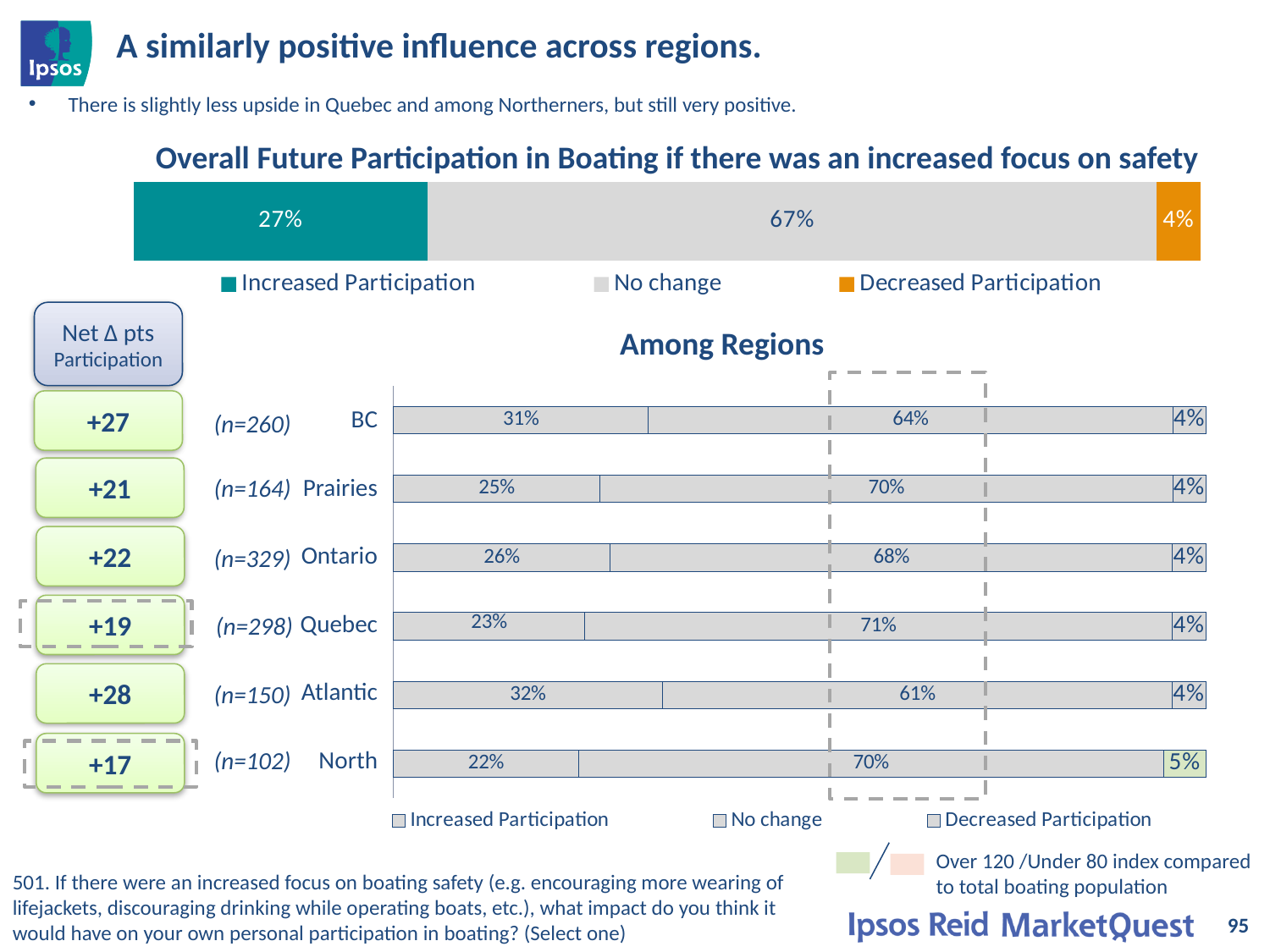
In the top 'Overall Future Participation in Boating if there was an increased focus on safety' chart, what is the No change value? 67% In the 'Among Regions' chart, what is the difference between the Increased Participation values for Atlantic and Quebec? 9 percentage points How many series does the legend of the 'Among Regions' chart list? 3 What type of chart is the 'Among Regions' chart? Stacked bar chart In the 'Among Regions' chart, which region has the lowest Increased Participation value? North In the 'Among Regions' chart, what percentage of BC respondents indicated Increased Participation? 31% In the top overall chart, what is the difference between the Increased Participation and Decreased Participation values? 23 percentage points How many regions are shown in the 'Among Regions' chart? 6 In the 'Among Regions' chart, which region has the highest Increased Participation value? Atlantic In the 'Among Regions' chart, is the No change value larger for Prairies or for Ontario? Prairies In the 'Among Regions' chart, what is the No change value for Quebec? 71% In the 'Among Regions' chart, what is the Decreased Participation value for North? 5%